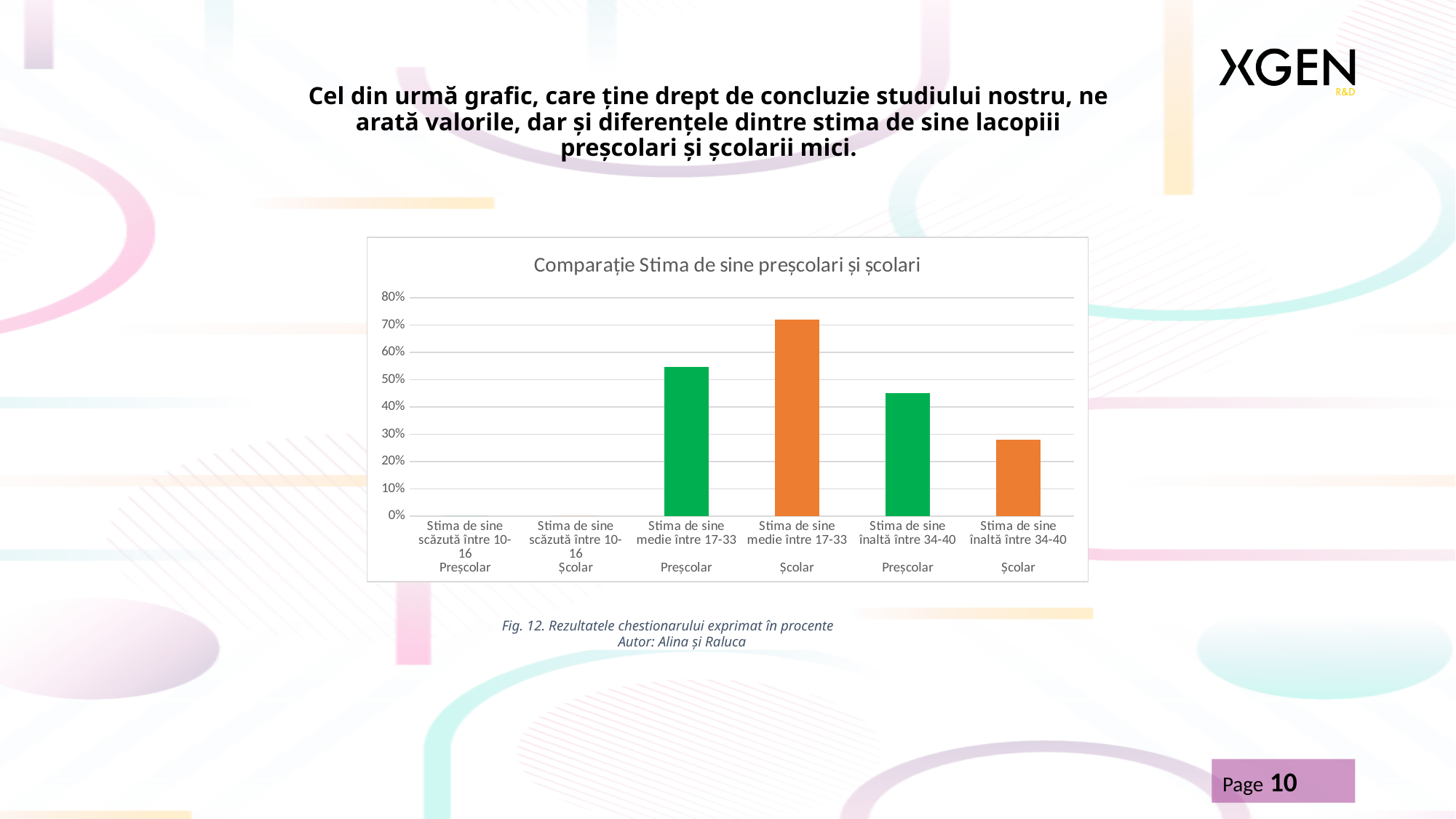
What colour are the bars for the Școlar categories? orange How many categories are shown on the x axis of the chart? 6 Is the value for Stima de sine înaltă între 34-40 Școlar greater or less than 30%? less Is the value for Stima de sine medie între 17-33 Preșcolar greater or less than 50%? greater What type of chart is shown on the slide? bar chart What is the title of the chart? Comparație Stima de sine preșcolari și școlari Which category has the highest bar in the chart? Stima de sine medie între 17-33 Școlar Which is larger: the value for Stima de sine medie între 17-33 Preșcolar or the value for Stima de sine înaltă între 34-40 Preșcolar? Stima de sine medie între 17-33 Preșcolar Is the value for Stima de sine medie între 17-33 Școlar greater or less than 70%? greater Among the categories with a visible bar, which one has the lowest value? Stima de sine înaltă între 34-40 Școlar How many categories in the chart have no visible bar? 2